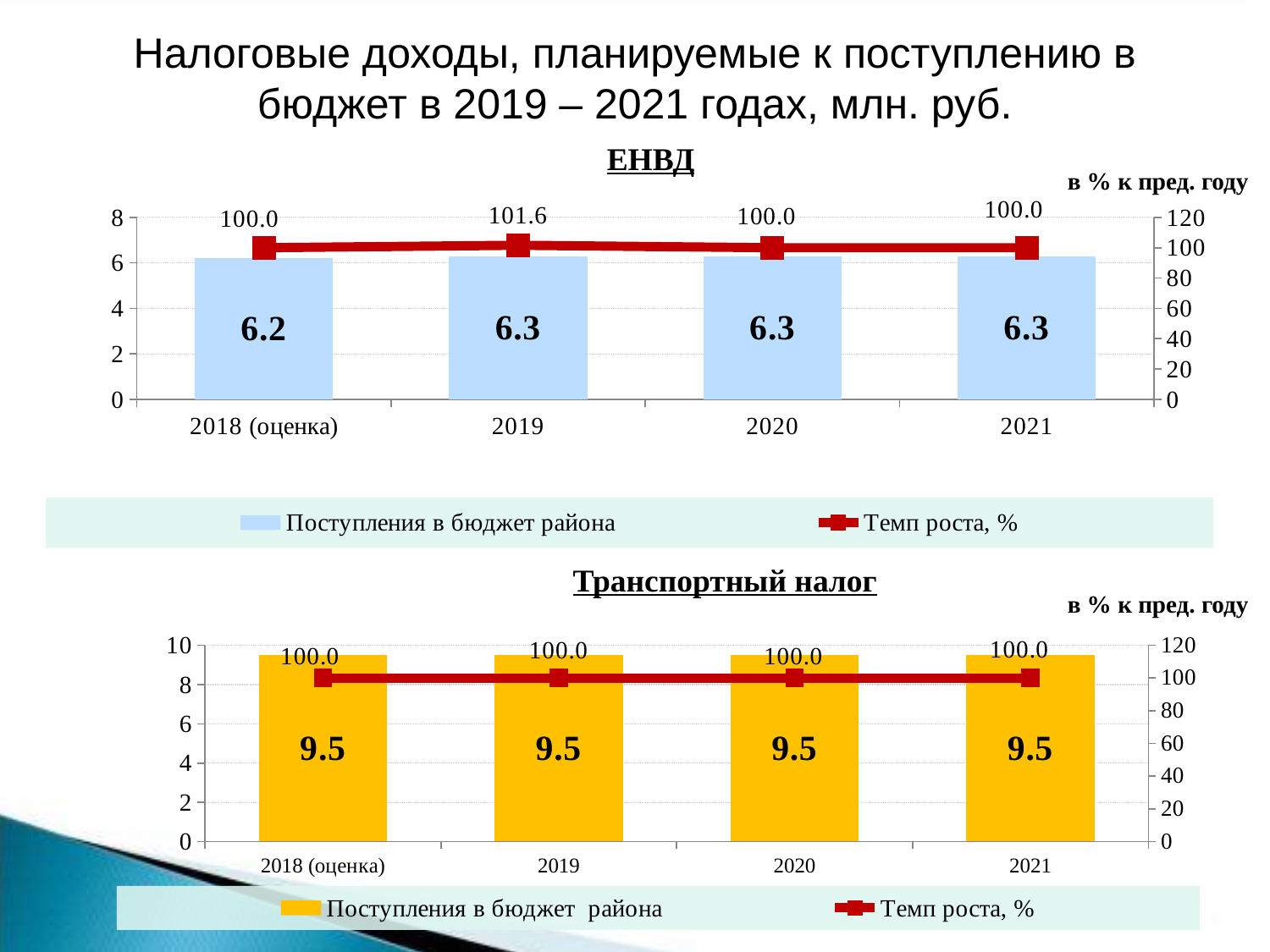
What kind of chart is the Транспортный налог chart? Combined bar and line chart In the ЕНВД chart, what is the Темп роста, % value for 2019? 101.6 In the Транспортный налог chart, do the Поступления в бюджет района values rise, fall or stay flat from 2018 (оценка) to 2021? stay flat Which is larger: the Поступления в бюджет района value for 2019 in the ЕНВД chart or in the Транспортный налог chart? Транспортный налог In the ЕНВД chart, what is the difference between the Поступления в бюджет района values for 2019 and 2018 (оценка)? 0.1 In the ЕНВД chart, how many series does the legend list? 2 In the ЕНВД chart, what is the value of Поступления в бюджет района for 2018 (оценка)? 6.2 In the ЕНВД chart, which year has the lowest value of Поступления в бюджет района? 2018 (оценка) In the Транспортный налог chart, how many years are shown on the x axis? 4 In the ЕНВД chart, which year has the highest Темп роста, % value? 2019 In the Транспортный налог chart, what is the Темп роста, % value for 2020? 100.0 In the Транспортный налог chart, what is the value of Поступления в бюджет района for 2021? 9.5